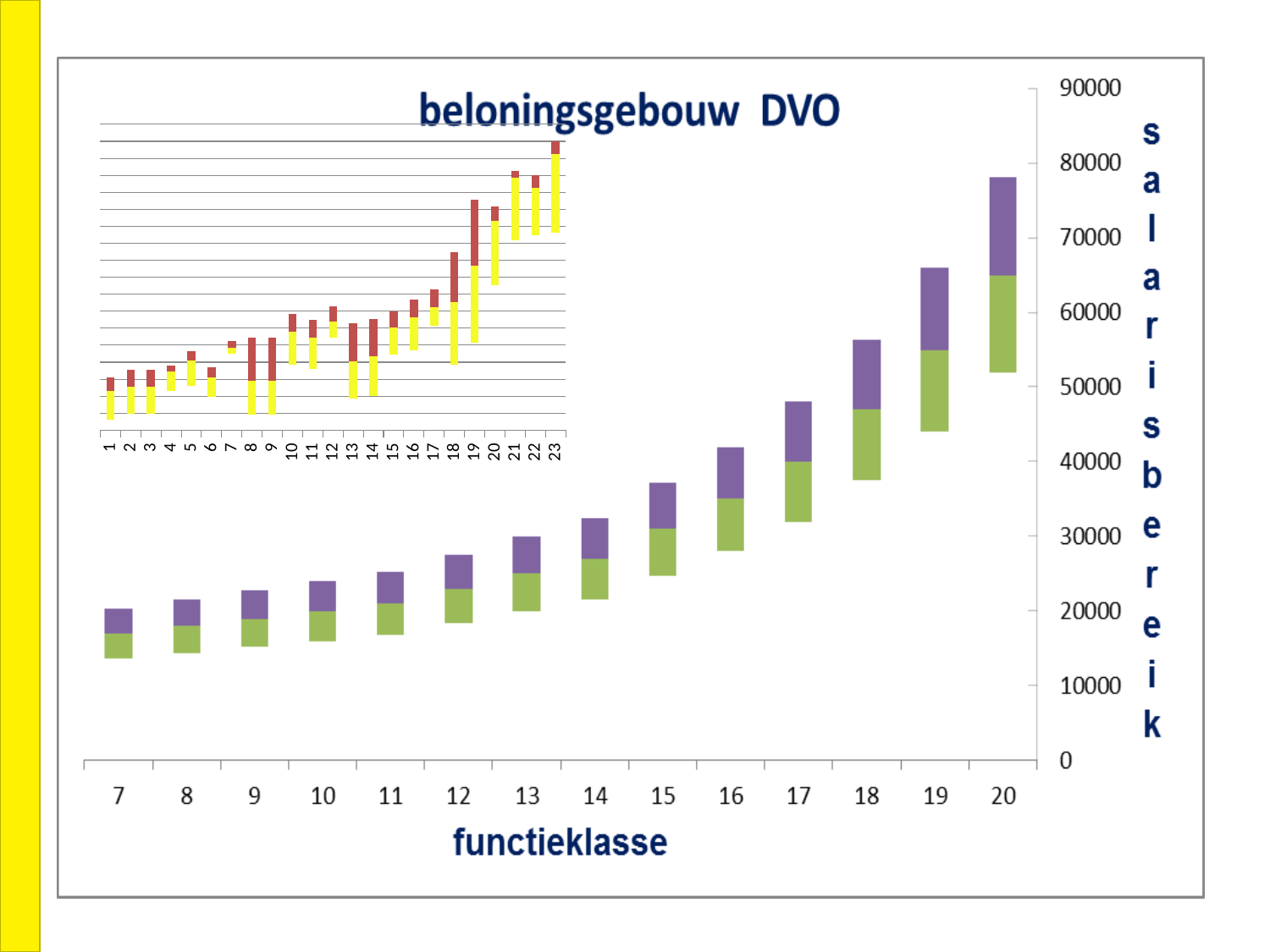
On the main chart titled 'beloningsgebouw DVO', is the top of the bar for functieklasse 17 greater or less than 50000? less On the main chart titled 'beloningsgebouw DVO', which functieklasse has the lowest bar? 7 On the main chart titled 'beloningsgebouw DVO', do the bars rise or fall as functieklasse increases from 7 to 20? rise On the main chart titled 'beloningsgebouw DVO', what kind of chart is shown? bar chart On the main chart titled 'beloningsgebouw DVO', is the top of the bar for functieklasse 19 greater or less than 60000? greater On the main chart titled 'beloningsgebouw DVO', which functieklasse has the highest top of its bar? 20 On the main chart titled 'beloningsgebouw DVO', is the bottom of the bar for functieklasse 7 greater or less than 20000? less On the main chart titled 'beloningsgebouw DVO', how many functieklasse categories are shown on the x axis? 14 On the small inset chart in the upper left, how many categories are shown on the x axis? 23 On the main chart titled 'beloningsgebouw DVO', what is the label of the x axis? functieklasse